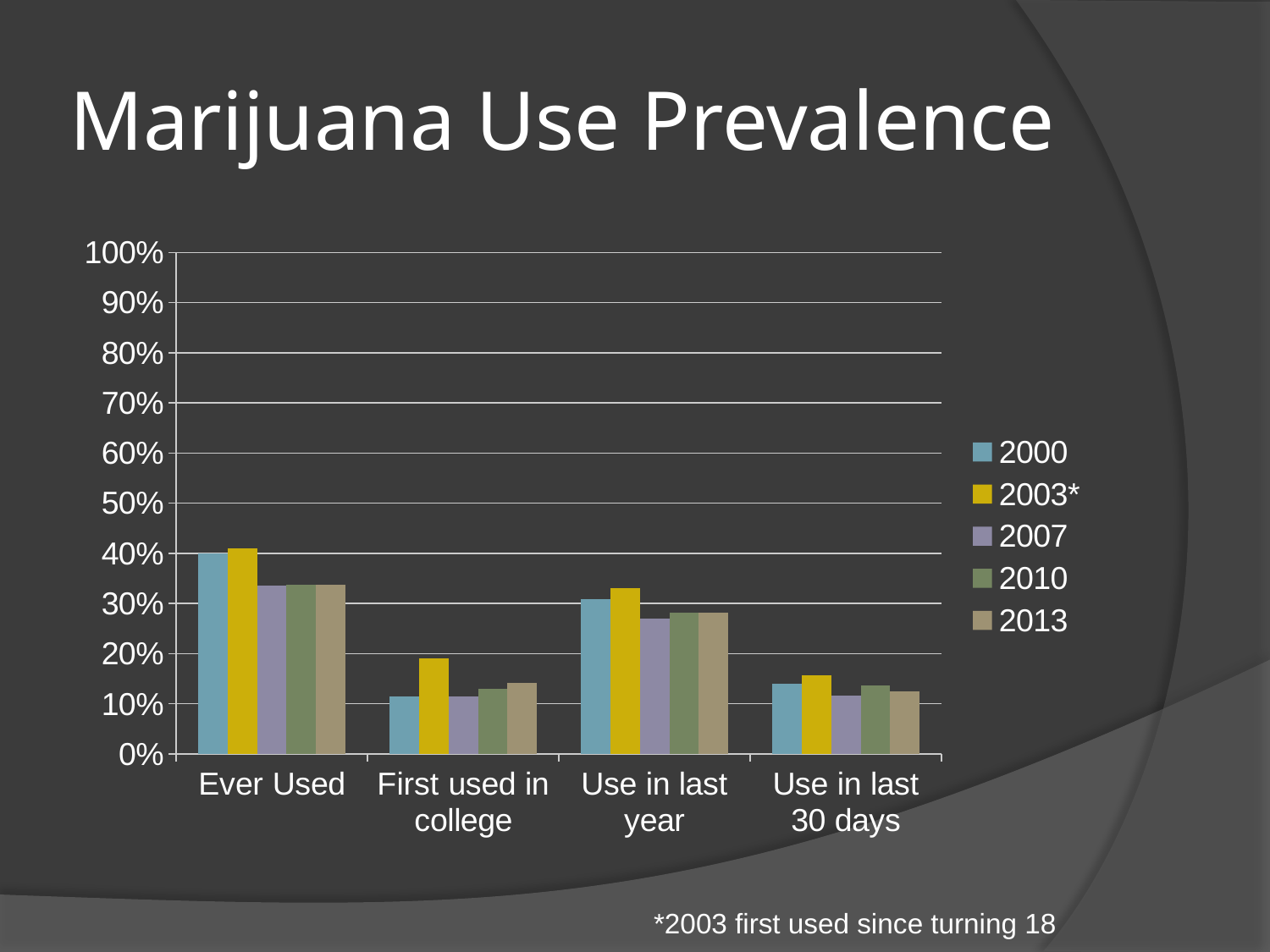
Is the value for 2000 in the Ever Used category greater or less than 30%? greater In the First used in college category, which is larger: the value for 2003* or the value for 2010? 2003* What is the title of the chart on the slide? Marijuana Use Prevalence In the Ever Used category, which is larger: the value for 2003* or the value for 2007? 2003* Is the value for 2007 in the Use in last 30 days category greater or less than 20%? less What kind of chart is shown on the slide? Bar chart How many categories are shown along the x axis of the chart? 4 Is the value for 2007 in the Use in last year category greater or less than 20%? greater In which category is the 2000 bar the lowest? First used in college In which category is the 2003* bar the highest? Ever Used How many series does the chart's legend list? 5